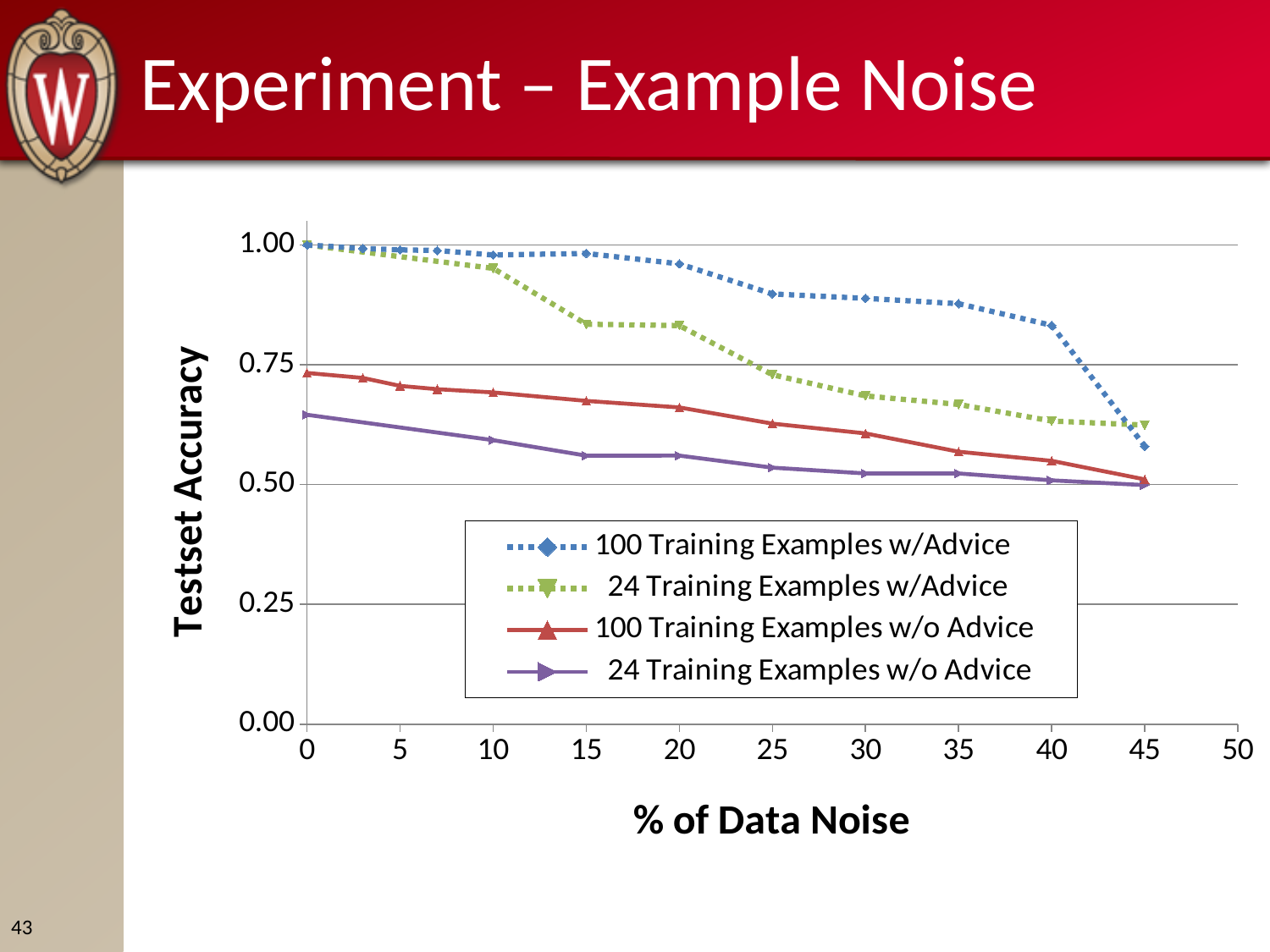
As the % of Data Noise increases, does the Testset Accuracy for 100 Training Examples w/Advice rise or fall? fall Is the Testset Accuracy for 100 Training Examples w/Advice at 0% data noise greater or less than 0.75? greater Is the Testset Accuracy for 24 Training Examples w/o Advice at 45% data noise greater or less than 0.75? less What kind of chart is shown on the slide? line chart At 20% data noise, which series has the higher Testset Accuracy: 100 Training Examples w/Advice or 24 Training Examples w/o Advice? 100 Training Examples w/Advice Is the Testset Accuracy for 100 Training Examples w/Advice at 45% data noise greater or less than 0.75? less How many series does the legend list? 4 What is the title of the y axis? Testset Accuracy Which series has the highest Testset Accuracy at 30% data noise? 100 Training Examples w/Advice What is the title of the x axis? % of Data Noise Which series has the lowest Testset Accuracy at 0% data noise? 24 Training Examples w/o Advice